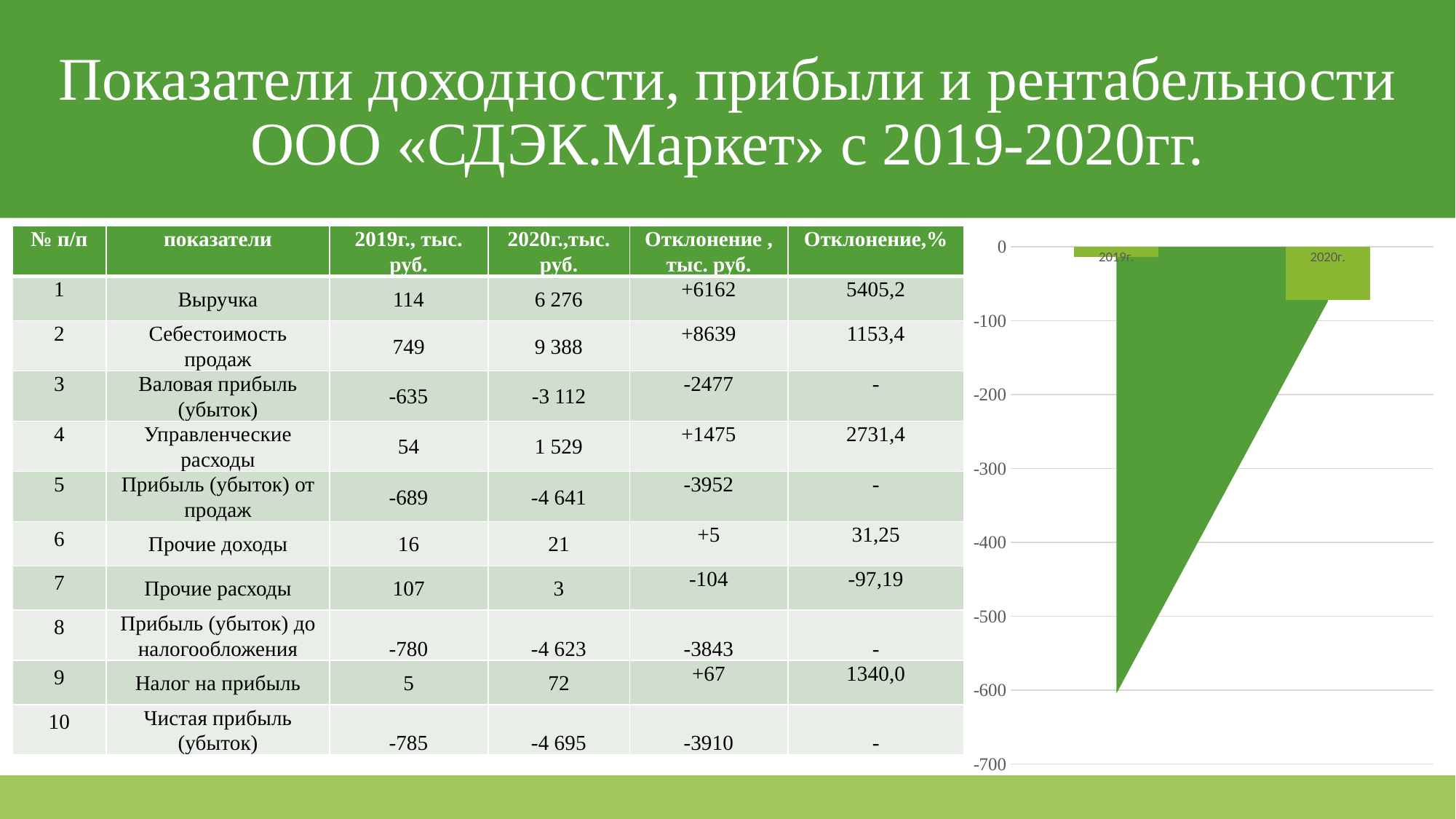
In the chart on the right of the slide, is the value of the light green series for 2020г. greater or less than -100? greater In the chart on the right of the slide, is the value of the dark green series for 2019г. greater or less than -500? less How many categories are shown on the x axis of the chart on the right of the slide? 2 In the chart on the right of the slide, does the dark green series rise or fall from 2019г. to 2020г.? rise What are the category labels on the x axis of the chart on the right of the slide? 2019г. and 2020г. In the chart on the right of the slide, is the value of the dark green series for 2020г. greater or less than -100? greater What is the lowest tick value shown on the vertical axis of the chart on the right of the slide? -700 In the chart on the right of the slide, which category has the lower value for the dark green series, 2019г. or 2020г.? 2019г.